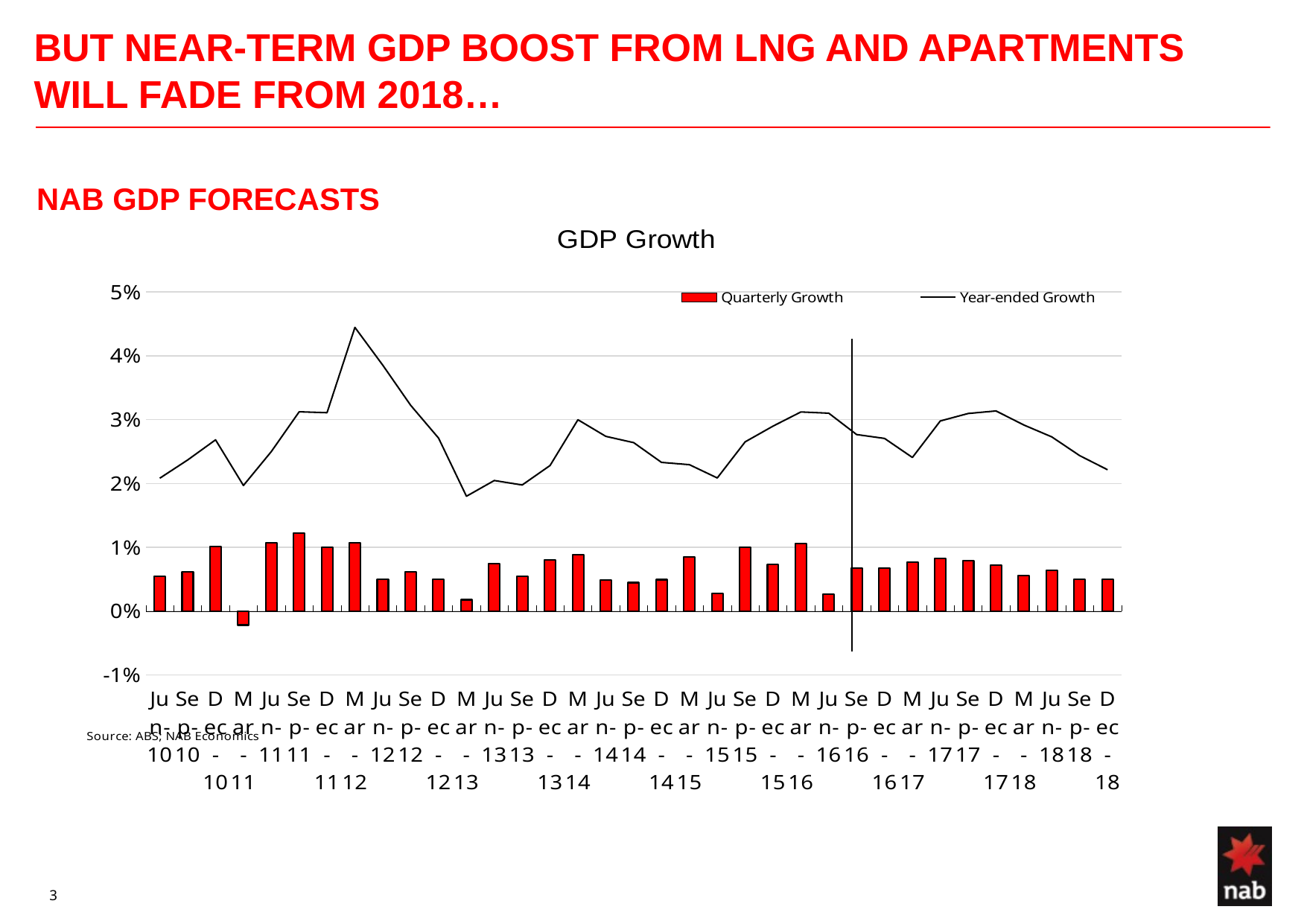
Is the Quarterly Growth value for Mar-11 greater or less than 0%? less How many quarters are plotted along the x axis of the GDP Growth chart? 35 Does the Year-ended Growth line rise or fall between Dec-17 and Dec-18? fall Which quarter has the lowest Quarterly Growth bar? Mar-11 What are the two series named in the legend of the GDP Growth chart? Quarterly Growth and Year-ended Growth How many series does the legend of the GDP Growth chart list? 2 What kind of chart is shown on the slide? A combined bar and line chart What is the title of the chart? GDP Growth Is the Year-ended Growth value for Mar-12 greater or less than 4%? greater Which quarter has the highest Quarterly Growth bar? Sep-11 Is the Year-ended Growth value for Mar-13 greater or less than 2%? less In which quarter does the Year-ended Growth line reach its highest point? Mar-12